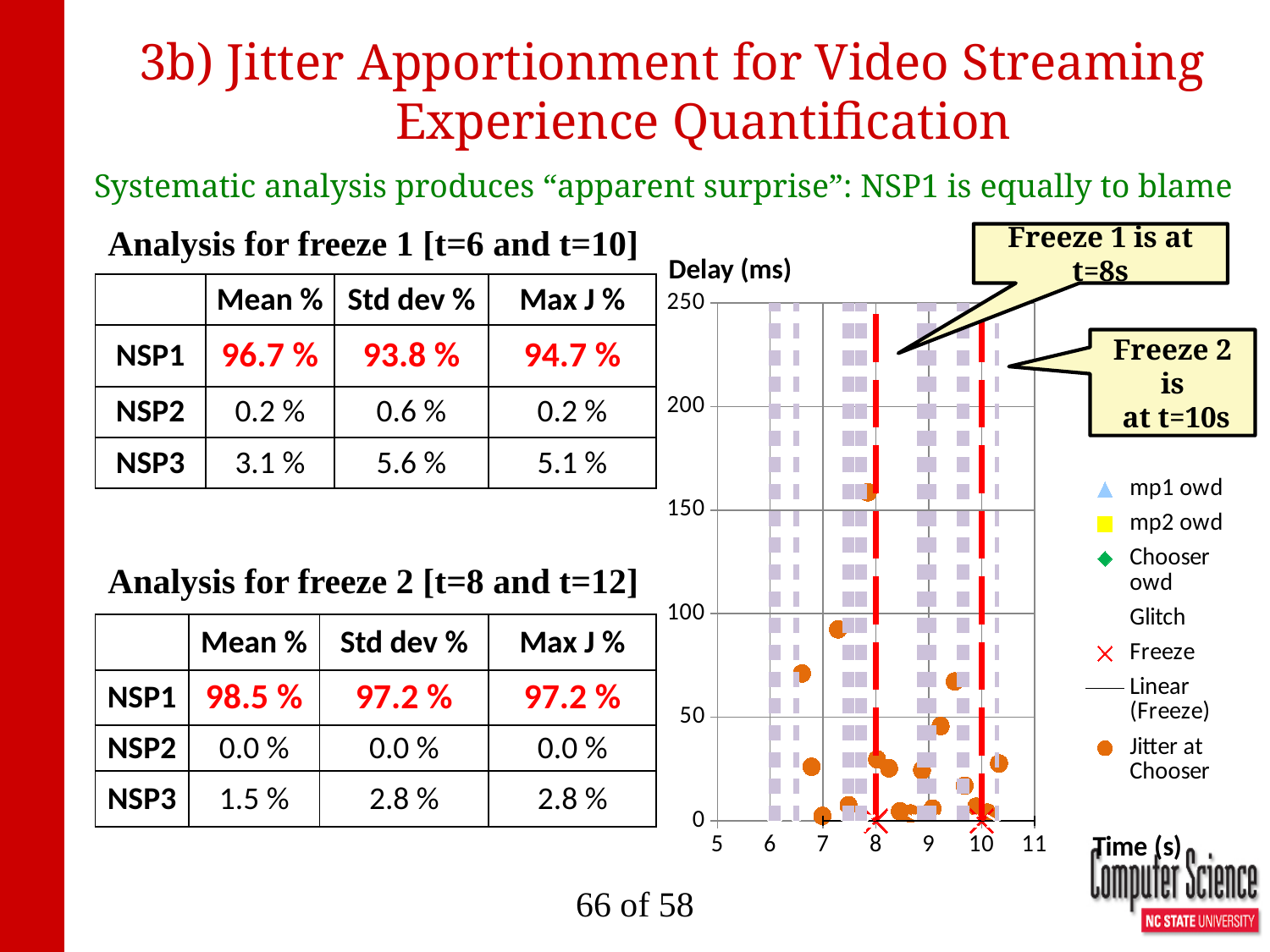
What kind of chart is shown on the right of the slide? scatter chart What is the title of the chart's horizontal axis? Time (s) How many tick labels are shown on the chart's horizontal (Time) axis? 7 How many series does the chart's legend list? 7 According to the callout on the chart, at what time does Freeze 1 occur? t=8s Is the highest 'Jitter at Chooser' point on the chart greater or less than 100 ms? greater According to the callout on the chart, at what time does Freeze 2 occur? t=10s What is the title of the chart's vertical axis? Delay (ms) Which of the two freeze markers on the chart occurs later in time, Freeze 1 or Freeze 2? Freeze 2